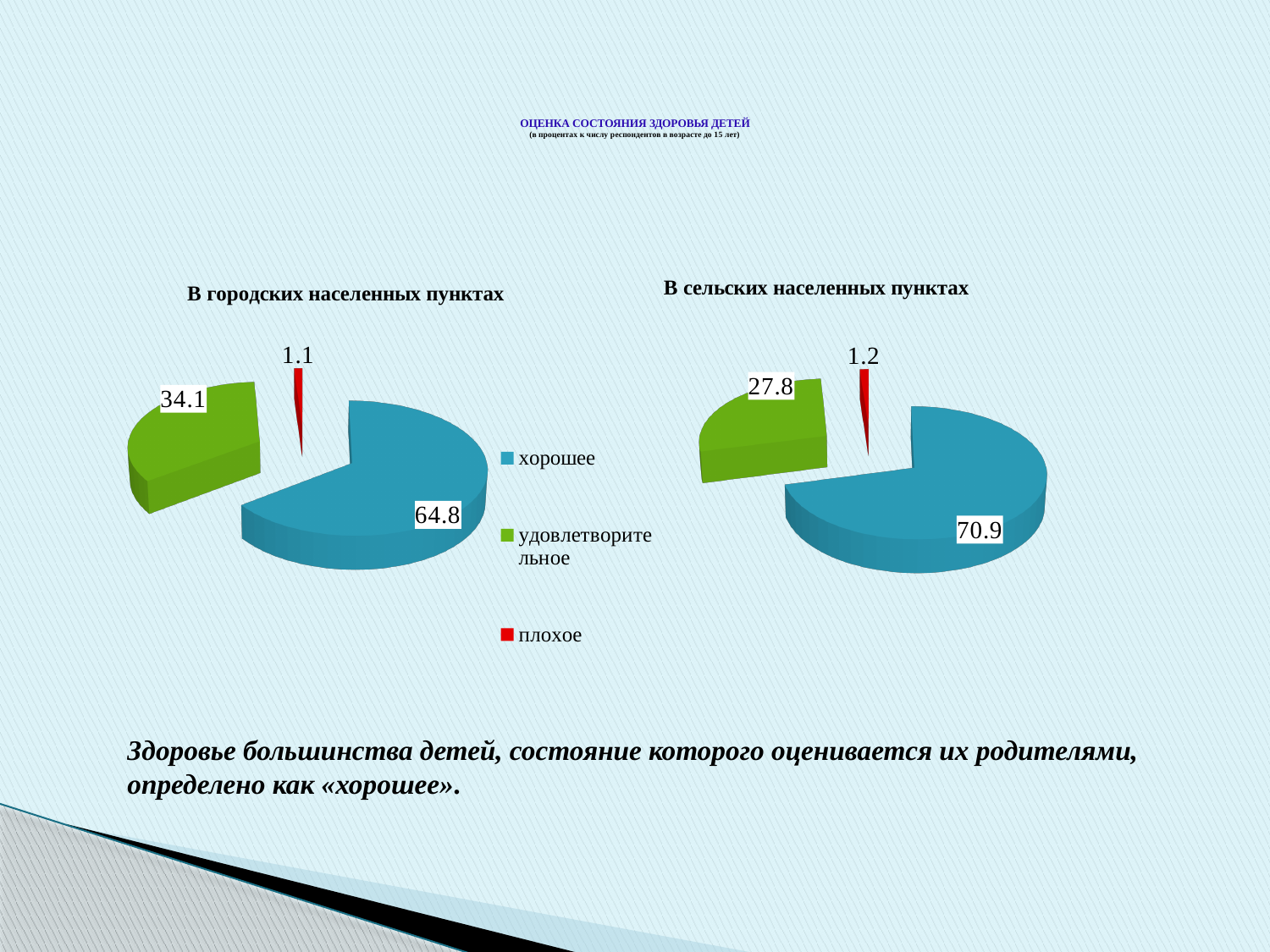
Где доля «удовлетворительное» больше: в городских или в сельских населенных пунктах? в городских населенных пунктах На диаграмме «В городских населенных пунктах» какое значение у категории «плохое»? 1.1 Сколько категорий показано на диаграмме «В сельских населенных пунктах»? 3 На диаграмме «В сельских населенных пунктах» какое значение у категории «хорошее»? 70.9 На диаграмме «В городских населенных пунктах» какая разница между значениями «хорошее» и «удовлетворительное»? 30.7 Какого типа диаграммы показаны на слайде? круговые диаграммы На диаграмме «В городских населенных пунктах» какая категория имеет наименьшую долю? плохое На диаграмме «В сельских населенных пунктах» какое значение у категории «удовлетворительное»? 27.8 На диаграмме «В сельских населенных пунктах» какая категория имеет наибольшую долю? хорошее На диаграмме «В городских населенных пунктах» какое значение у категории «хорошее»? 64.8 Каким цветом на диаграммах обозначена категория «плохое»? красным На сколько значение «хорошее» на диаграмме «В сельских населенных пунктах» больше, чем на диаграмме «В городских населенных пунктах»? 6.1